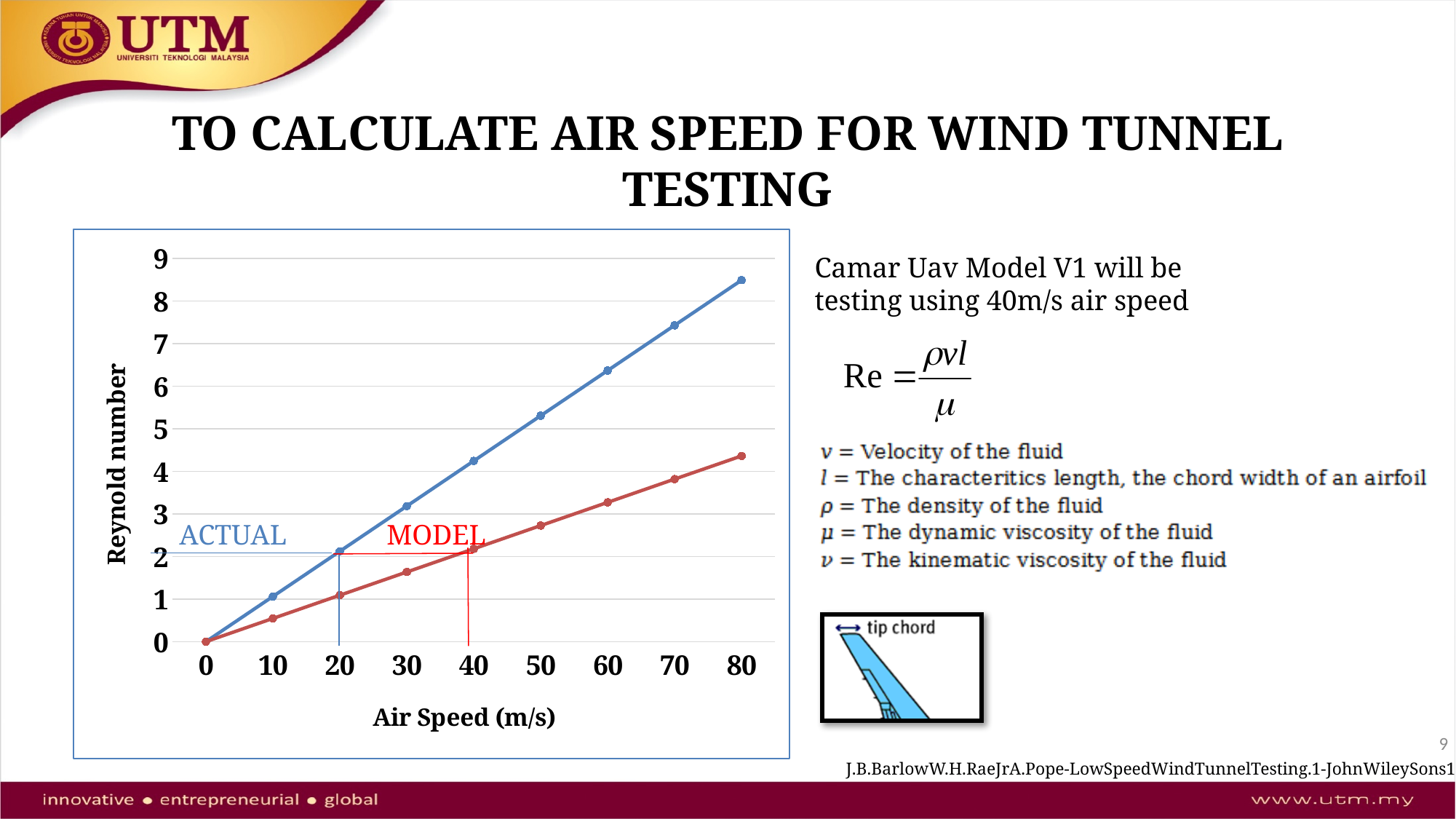
What is the Reynold number for the ACTUAL series at an air speed of 0 m/s? 0 What is the title of the x axis of the chart? Air Speed (m/s) Do the Reynold number values rise or fall as air speed increases? rise At 80 m/s, which series has the larger Reynold number, ACTUAL or MODEL? ACTUAL Is the MODEL Reynold number at 40 m/s greater or less than 3? less What kind of chart is shown on the slide? line chart Which series has the higher Reynold number across the chart, ACTUAL or MODEL? ACTUAL Is the MODEL Reynold number at 80 m/s greater or less than 5? less How many series are plotted on the chart? 2 Is the ACTUAL Reynold number at 80 m/s greater or less than 8? greater How many air speed points are plotted for each series on the chart? 9